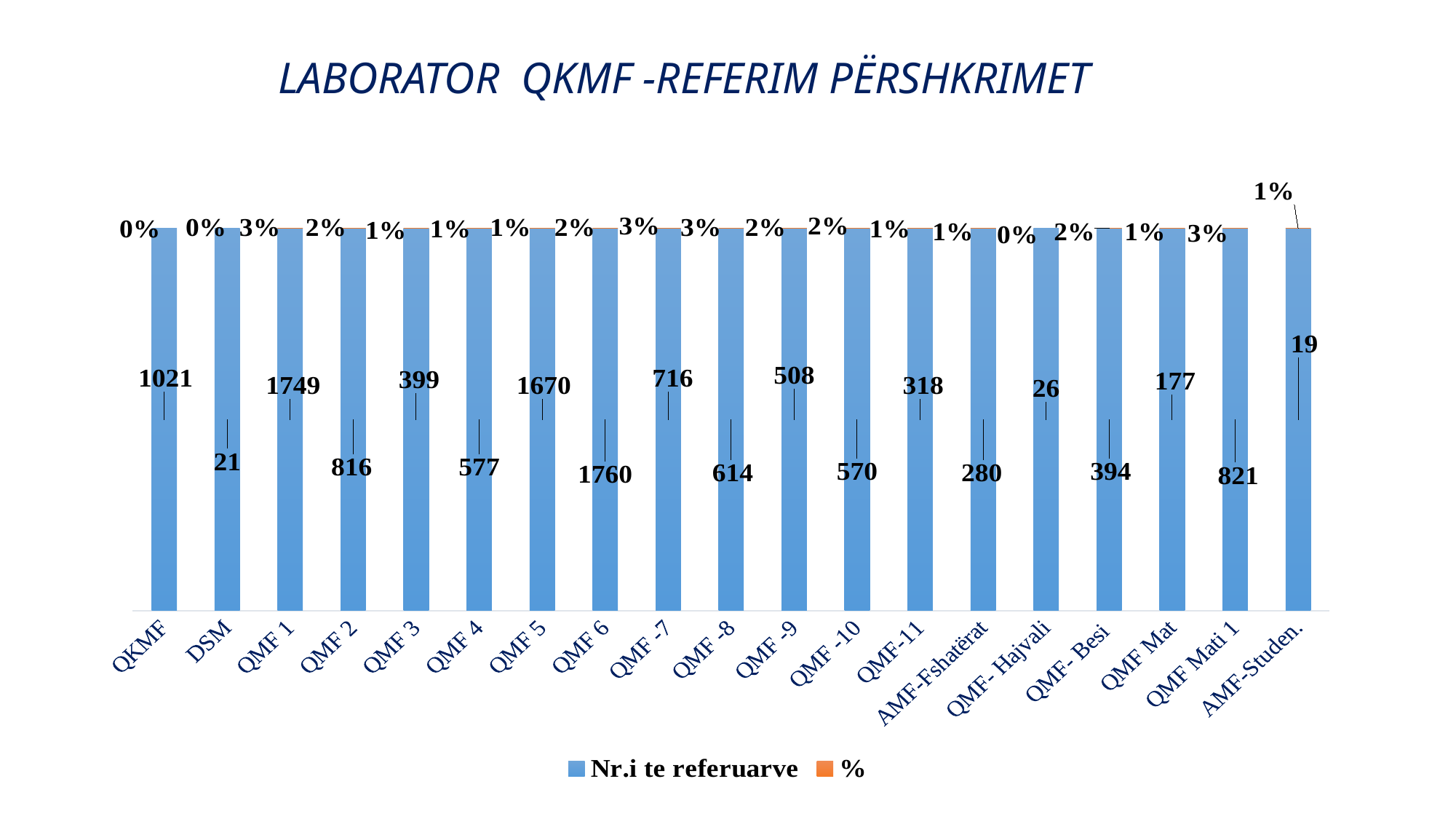
Which category has the lowest Nr.i te referuarve value according to the data labels? AMF-Studen. How many categories are shown on the x axis? 19 What is the value of Nr.i te referuarve for AMF-Fshatërat? 280 What is the value of Nr.i te referuarve for QMF- Hajvali? 26 What is the title of the chart? LABORATOR QKMF -REFERIM PËRSHKRIMET What is the value of Nr.i te referuarve for QMF Mati 1? 821 What is the value of Nr.i te referuarve for QMF 1? 1749 Which category has the highest Nr.i te referuarve value according to the data labels? QMF 6 How many series does the legend list? 2 What is the difference between the Nr.i te referuarve values for QKMF and DSM? 1000 Which has a larger Nr.i te referuarve value, QMF 5 or QMF -7? QMF 5 What kind of chart is shown on the slide? bar chart